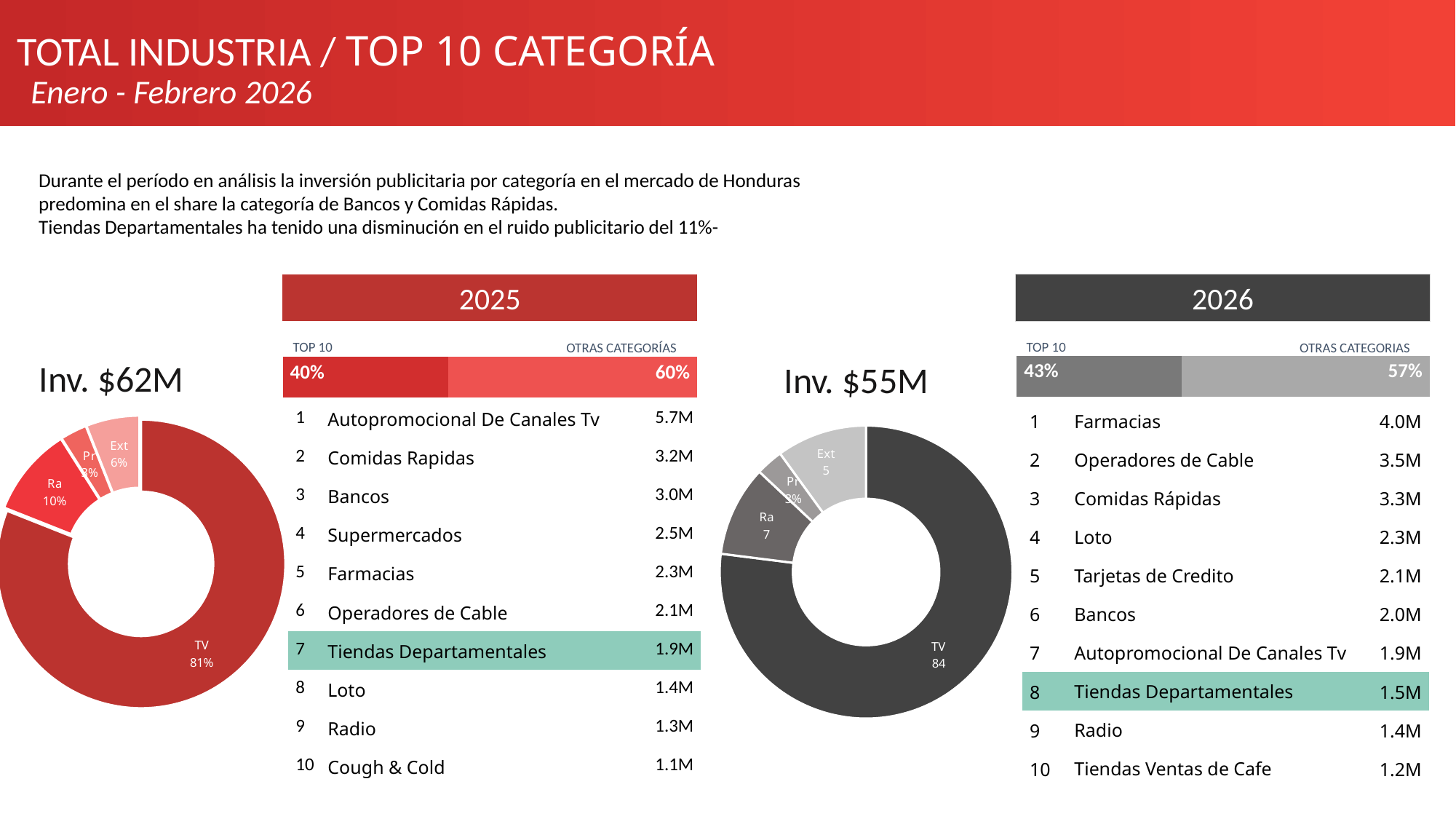
In the 2026 donut chart on the right, what is the value shown for TV? 84 In the 2025 donut chart on the left, what is the value shown for Ext? 6% What kind of chart is used to show the TV, Ra, Pr and Ext split for 2025? Pie chart (donut) In the 2026 donut chart on the right, what is the value shown for Ra? 7 In the 2025 donut chart on the left, what is the value shown for Ra? 10% In the 2025 donut chart on the left, which segment is the largest? TV In the 2025 stacked bar, what share is shown for TOP 10? 40% In the 2025 donut chart on the left, what share does TV have? 81% In the 2026 donut chart on the right, what is the value shown for Ext? 5 How many segments does the 2025 donut chart on the left have? 4 In the 2026 stacked bar, what share is shown for OTRAS CATEGORIAS? 57%